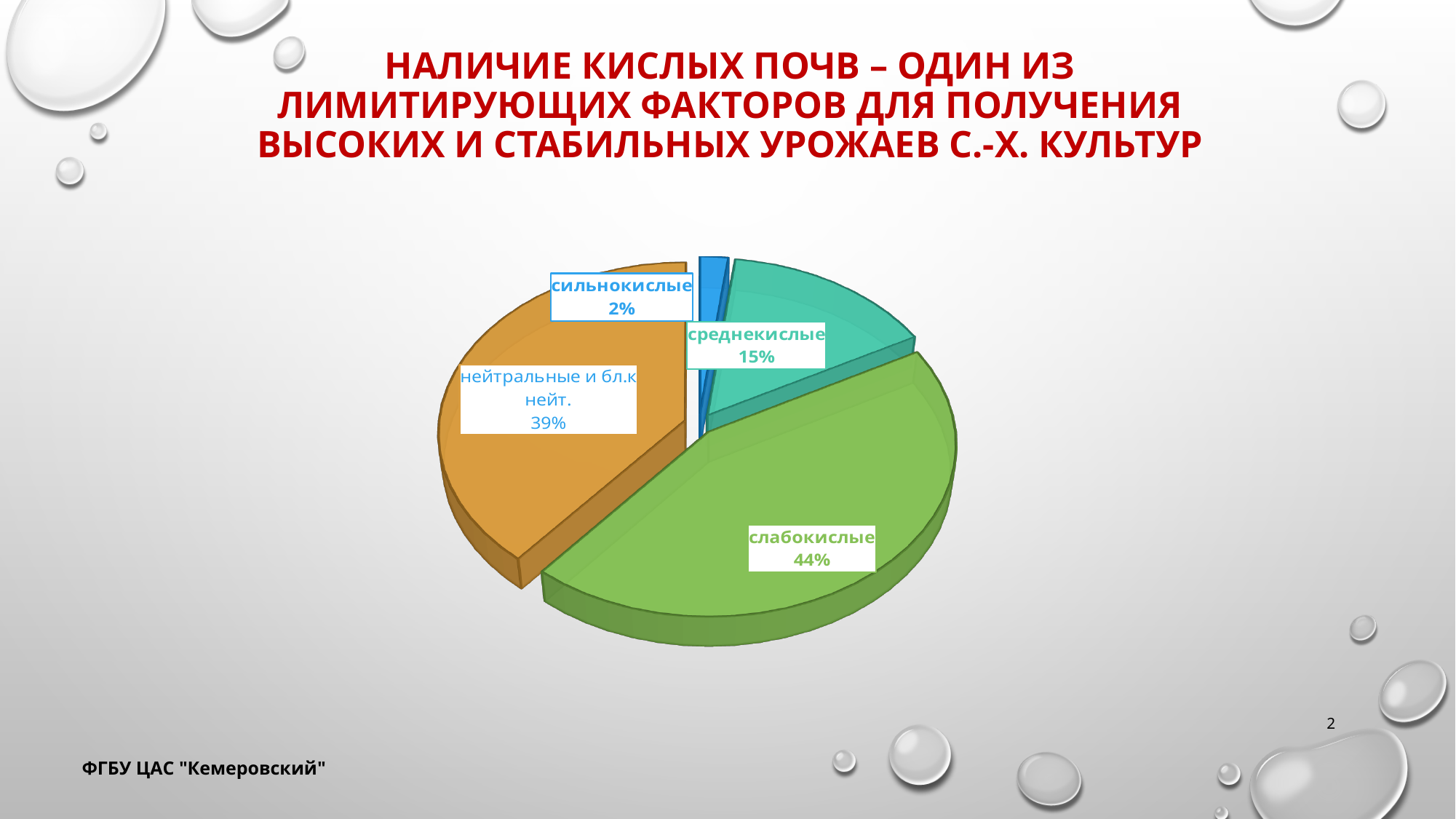
What kind of chart is shown on the slide? pie chart Which category has the largest slice of the pie? слабокислые Which is larger, the share for среднекислые or the share for нейтральные и бл.к нейт.? нейтральные и бл.к нейт. What is the difference in percentage points between слабокислые and нейтральные и бл.к нейт.? 5 What is the difference in percentage points between среднекислые and сильнокислые? 13 What share of the pie is labelled сильнокислые? 2% What colour is the slice for слабокислые? green What share of the pie is labelled нейтральные и бл.к нейт.? 39% What share of the pie is labelled среднекислые? 15% How many slices does the pie chart have? 4 Which category has the smallest slice of the pie? сильнокислые